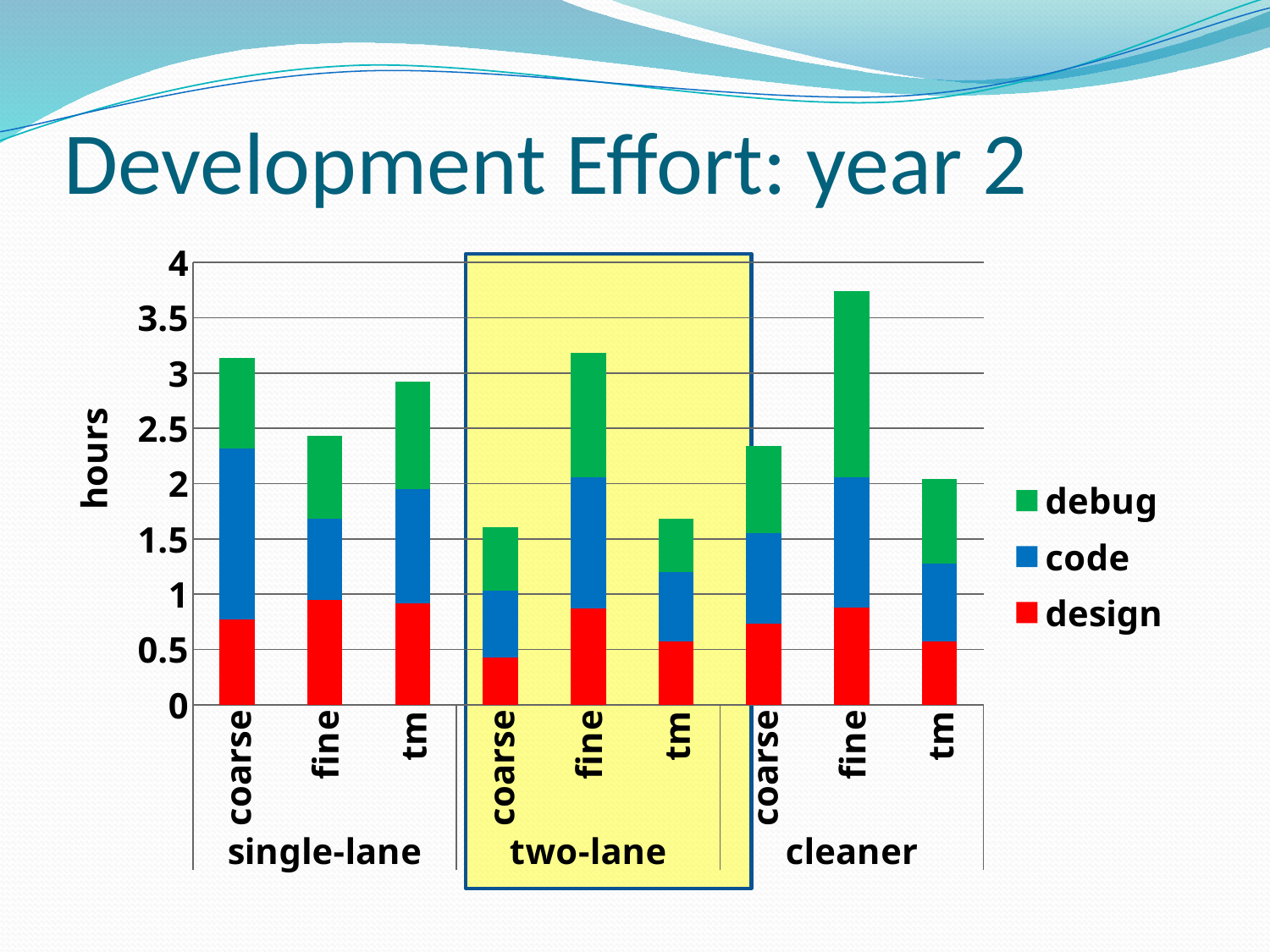
Is the total for the cleaner tm bar greater or less than 2.5? less Which has a larger total, the single-lane tm bar or the cleaner coarse bar? single-lane tm Which group of bars is highlighted with a yellow box? two-lane How many series does the legend list? 3 Is the total for the single-lane coarse bar greater or less than 3? greater Which bar has the highest total hours? cleaner fine What is the label on the vertical axis? hours Is the total for the two-lane coarse bar greater or less than 2? less Which has a larger total, the two-lane fine bar or the two-lane tm bar? two-lane fine What kind of chart is shown on the slide? stacked bar chart How many bars are plotted in the chart? 9